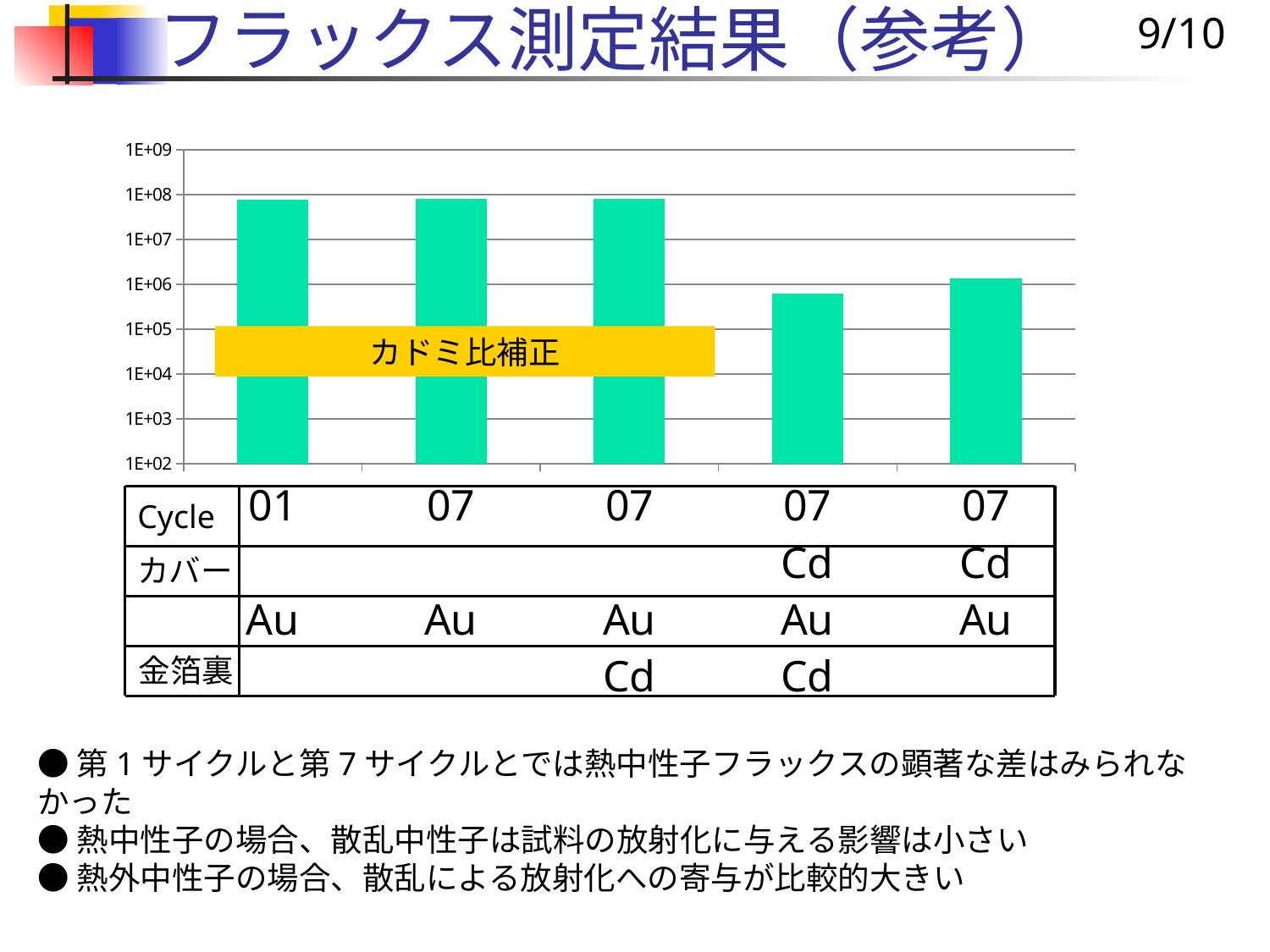
What kind of chart is shown on the slide? bar chart What is the highest tick value shown on the y axis? 1E+09 How many bars are plotted in the chart? 5 Which bar is the lowest in the chart? the fourth bar (Cycle 07, Cd cover, Cd behind the gold foil) Which is larger, the value of the fourth bar or the value of the fifth bar? the fifth bar Is the value of the fifth bar (Cd cover only) greater or less than 1E+06? greater Is the value of the fourth bar (Cd cover and Cd behind the gold foil) greater or less than 1E+06? less Which is larger, the value of the first bar (Cycle 01) or the value of the fifth bar (Cycle 07, Cd cover)? the first bar (Cycle 01) What text is written in the yellow box overlaid on the chart? カドミ比補正 Is the value of the first bar (Cycle 01) greater or less than 1E+08? less